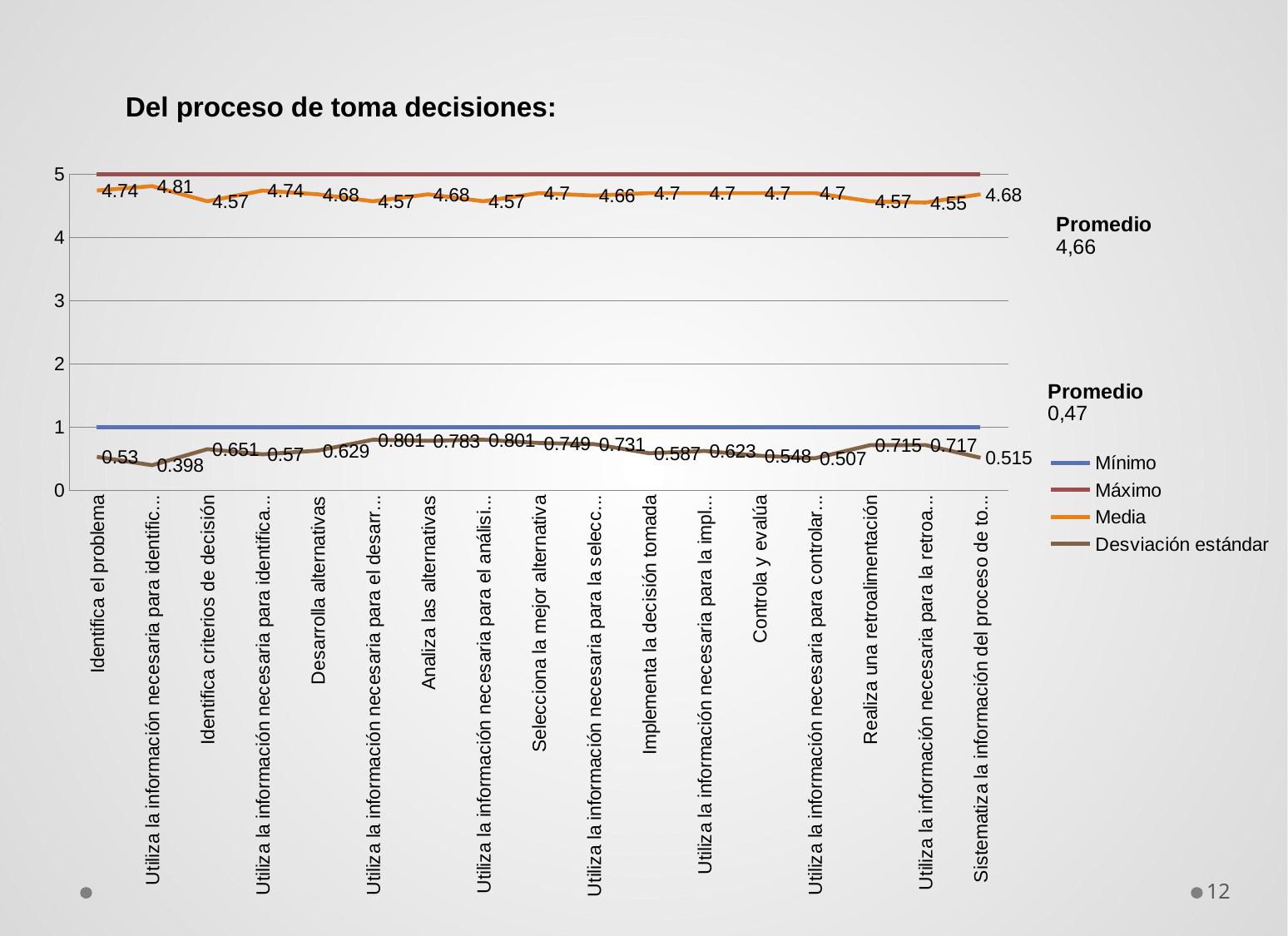
What is the Media value for 'Desarrolla alternativas'? 4.68 What is the Media value for 'Identifica el problema'? 4.74 What Promedio is shown next to the Media line on the slide? 4,66 What is the Desviación estándar value for 'Controla y evalúa'? 0.548 How many categories are plotted along the x axis? 17 How many series does the legend list? 4 What is the difference between the Media values for 'Identifica el problema' and 'Identifica criterios de decisión'? 0.17 Which has the larger Desviación estándar value, 'Analiza las alternativas' or 'Realiza una retroalimentación'? Analiza las alternativas What is the Media value for 'Implementa la decisión tomada'? 4.7 At what value does the Máximo line sit across all categories? 5 What kind of chart is shown on the slide? line chart What is the Desviación estándar value for 'Selecciona la mejor alternativa'? 0.749